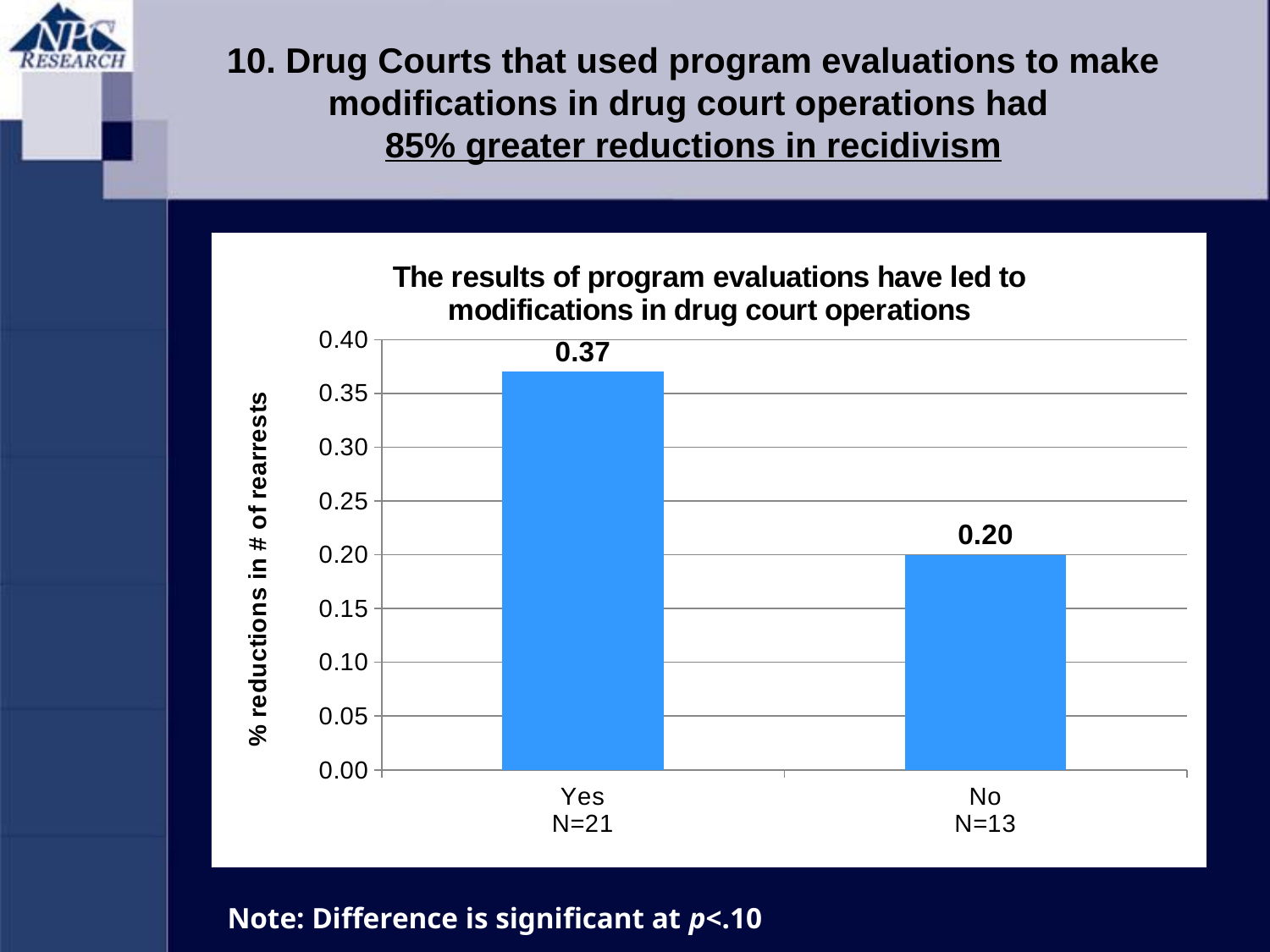
What kind of chart is shown on the slide? bar chart Is the value for "Yes" greater or less than 0.30? greater What is the value for the "No" category? 0.20 What is the title of the chart? The results of program evaluations have led to modifications in drug court operations What is the value for the "Yes" category? 0.37 Is the value for "No" greater or less than 0.25? less What is the difference between the values for "Yes" and "No"? 0.17 Which category has the highest value? Yes What is the label of the y axis? % reductions in # of rearrests Which is larger, the value for "Yes" or the value for "No"? Yes How many categories are shown in the chart? 2 Which category has the lowest value? No